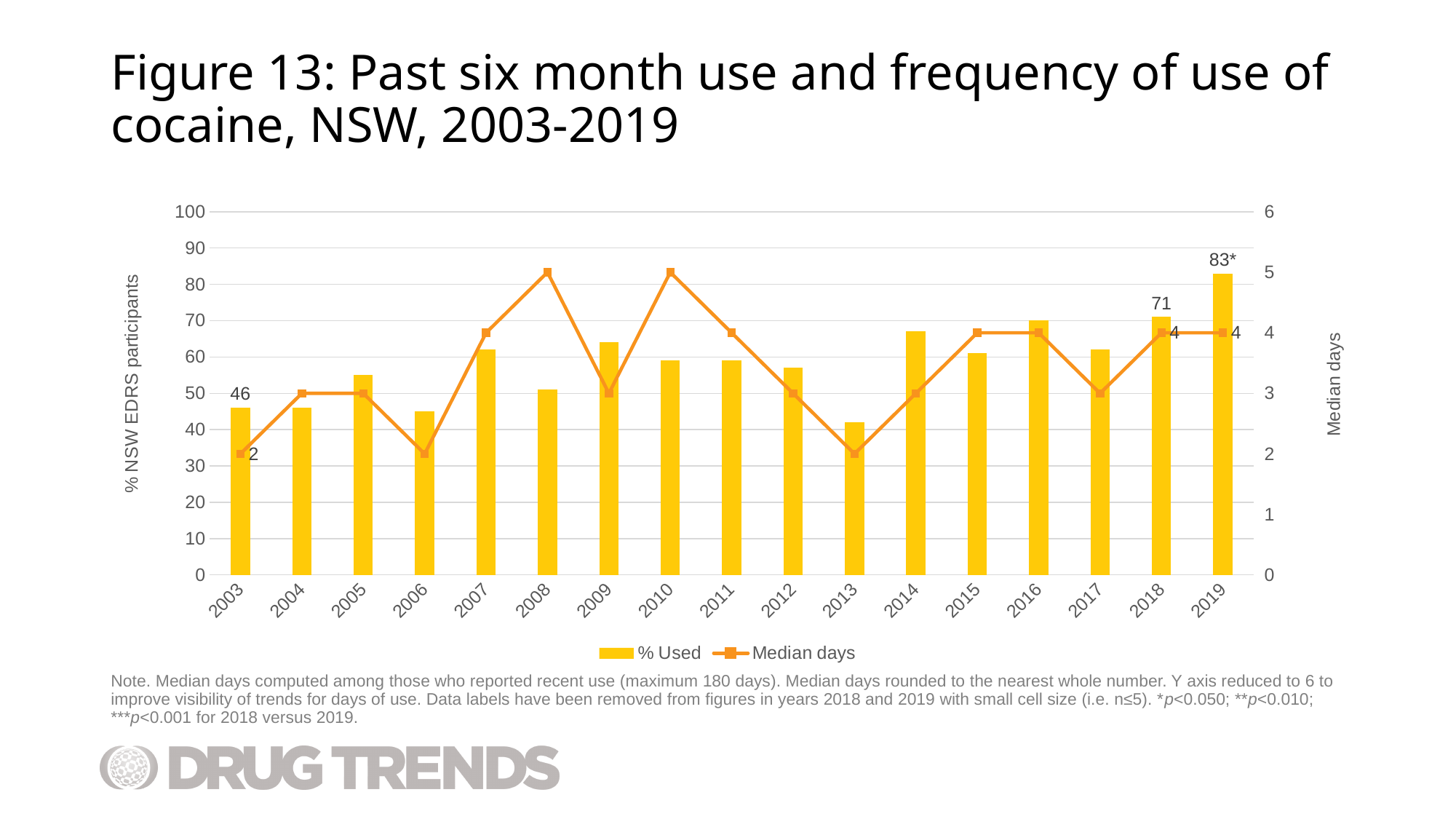
What is the Median days value for 2003? 2 Which year has the highest % Used bar? 2019 Which year has a higher % Used bar, 2016 or 2017? 2016 What is the % Used value for 2018? 71 How many years are shown on the x axis? 17 By how much did % Used increase from 2018 to 2019? 12 Is the % Used value for 2008 greater or less than 60? less What is the % Used value for 2003? 46 How many series does the legend list? 2 Is the Median days value for 2010 greater or less than 4? greater What is the Median days value for 2019? 4 What is the % Used value labelled for 2019? 83*